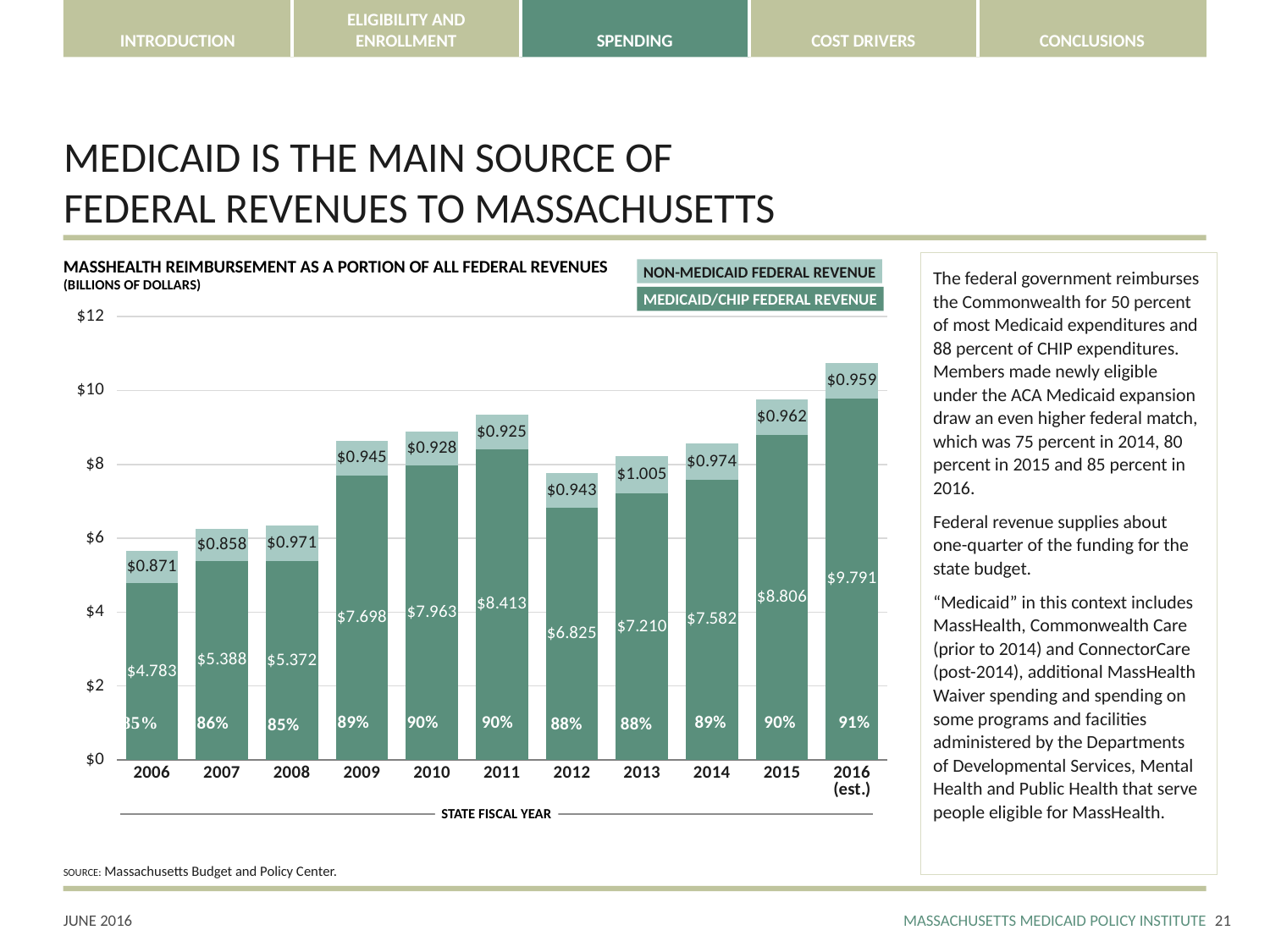
What percentage label is shown on the 2016 (est.) bar? 91% Which is larger, the Medicaid/CHIP federal revenue in 2009 or in 2012? 2009 What is the non-Medicaid federal revenue for 2013? $1.005 Which year has the highest Medicaid/CHIP federal revenue? 2016 (est.) What is the difference between the Medicaid/CHIP federal revenue in 2016 (est.) and in 2015? $0.985 How many series does the legend list? 2 What is the total federal revenue (both segments) for 2016 (est.)? $10.750 Which year has the highest non-Medicaid federal revenue? 2013 What kind of chart is shown on the slide? Stacked bar chart Which year has the lowest Medicaid/CHIP federal revenue? 2006 How many state fiscal years are shown on the x axis? 11 What is the Medicaid/CHIP federal revenue for 2011? $8.413